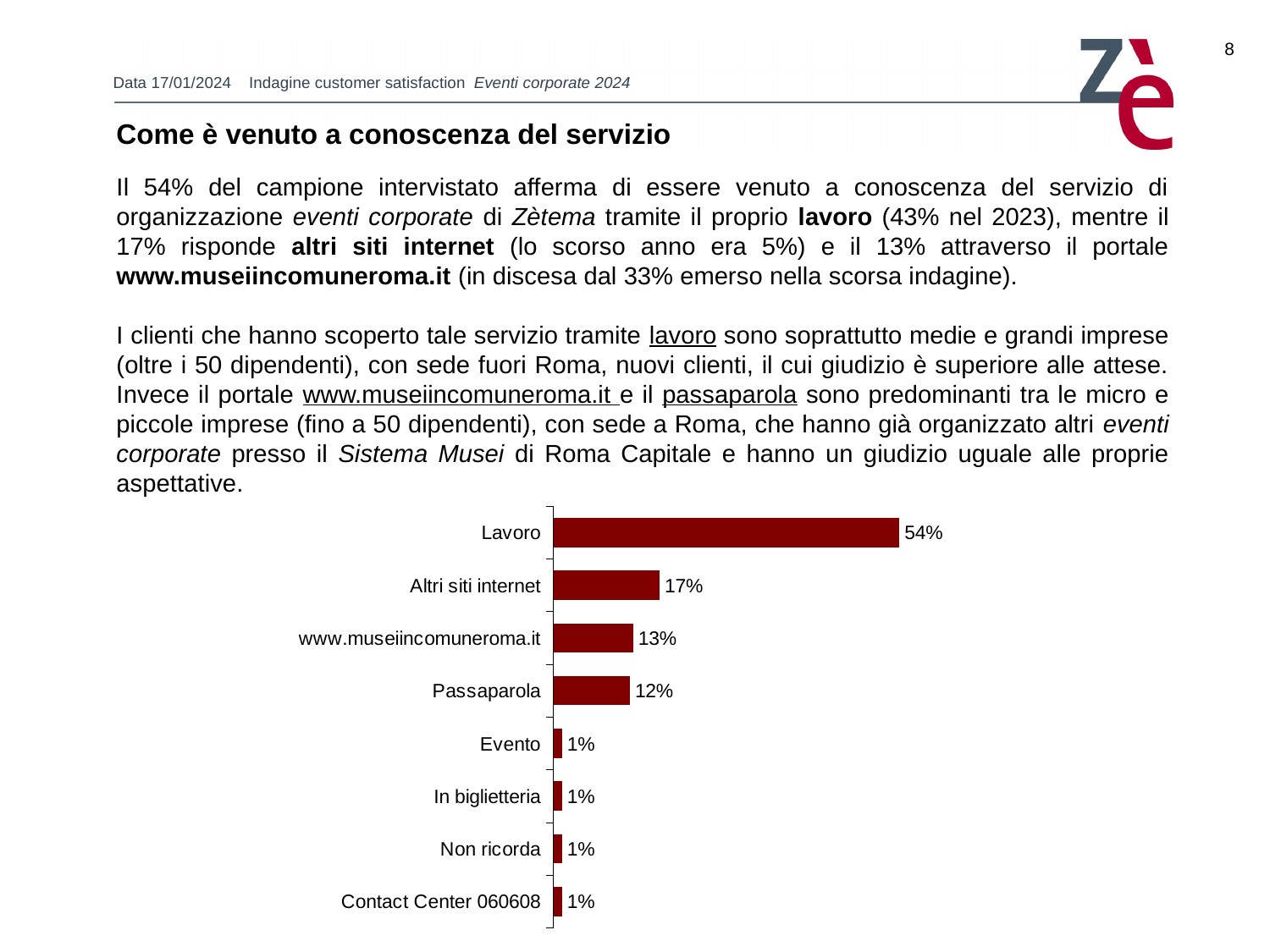
How many categories in the chart have a value of 1%? 4 What percentage is shown for www.museiincomuneroma.it? 13% What is the value shown for Altri siti internet? 17% How many categories are shown in the chart? 8 What is the difference between www.museiincomuneroma.it and Passaparola? 1% What is the value shown for Contact Center 060608? 1% What is the value for Passaparola? 12% Which category has the highest value in the chart? Lavoro What kind of chart is shown on the slide? Bar chart What percentage of respondents learned about the service through Lavoro? 54% What is the difference between the values for Lavoro and Altri siti internet? 37% Which is larger, Altri siti internet or Passaparola? Altri siti internet